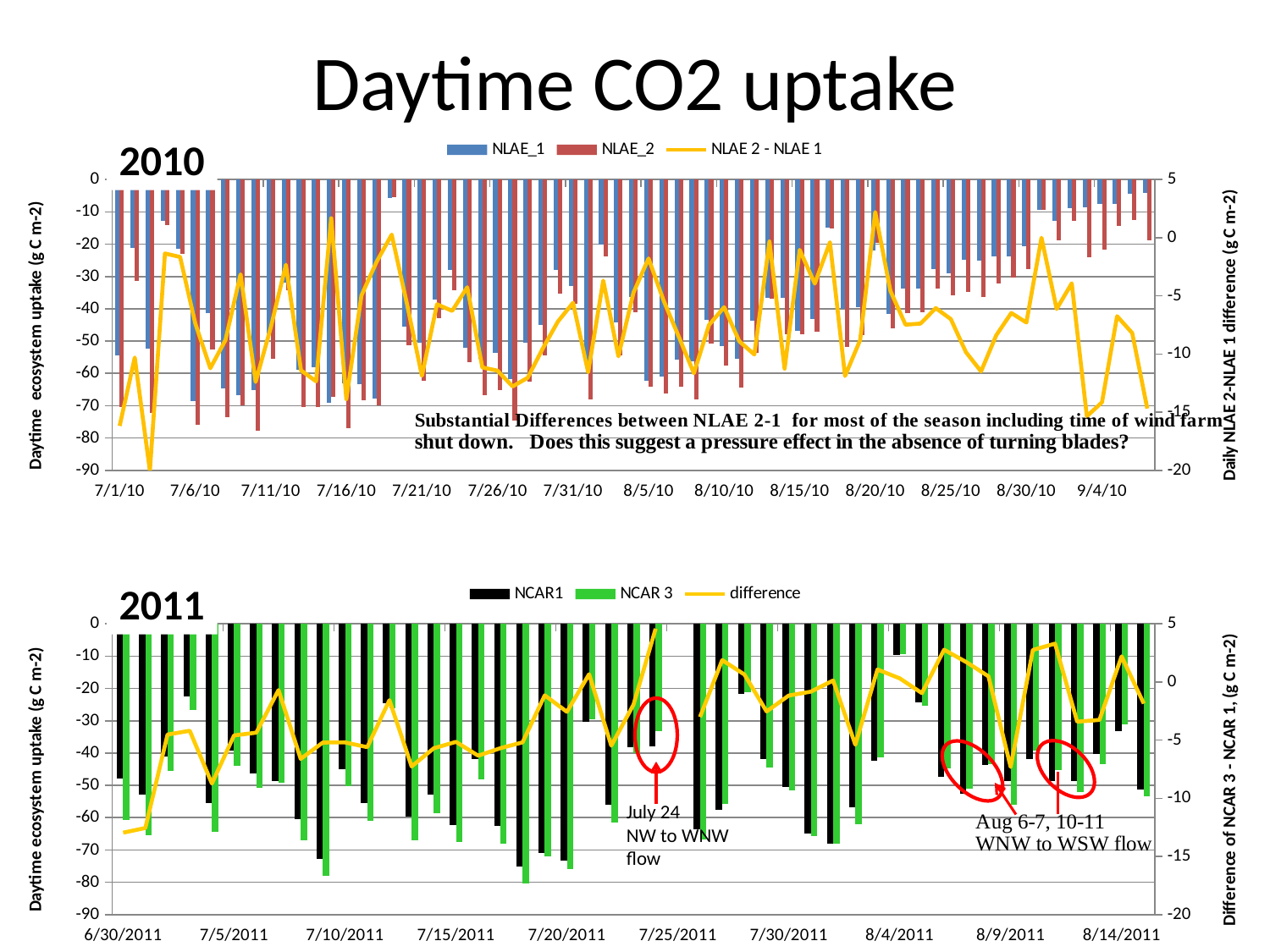
In the 2011 chart, is the lowest NCAR 3 bar greater or less than -70? less In the 2010 chart, which series is plotted as a line rather than bars? NLAE 2 - NLAE 1 In the 2010 chart, is the lowest point of the NLAE 2 - NLAE 1 line greater or less than -15 on the right axis? less How many series does the legend of the 2011 chart list? 3 In the 2011 chart, what colour are the NCAR 3 bars? Green What kind of chart is the 2011 chart at the bottom of the slide? Combined bar and line chart How many series does the legend of the 2010 chart list? 3 In the 2011 chart, is the NCAR1 value on 6/30/2011 greater or less than -60? greater What kind of chart is the 2010 chart at the top of the slide? Combined bar and line chart